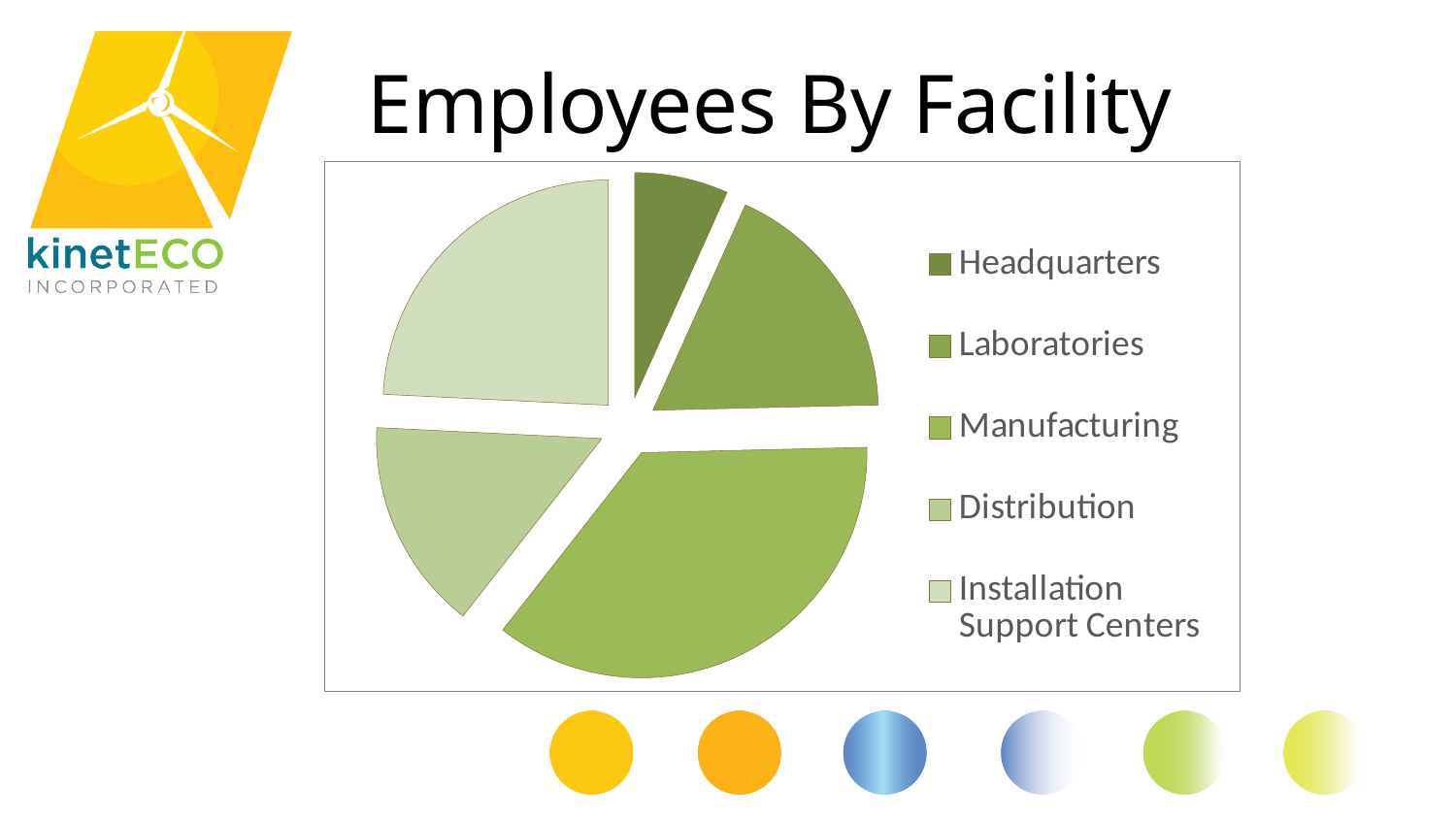
Which legend entry is listed last in the legend? Installation Support Centers How many entries does the legend list? 5 Which facility has the smallest share of employees? Headquarters Which facility has the largest share of employees? Manufacturing Which has a larger share of employees, Installation Support Centers or Distribution? Installation Support Centers What kind of chart is shown on the slide? Pie chart What is the title of the chart? Employees By Facility Which has a larger share of employees, Laboratories or Headquarters? Laboratories Which has a larger share of employees, Manufacturing or Installation Support Centers? Manufacturing How many slices does the pie chart have? 5